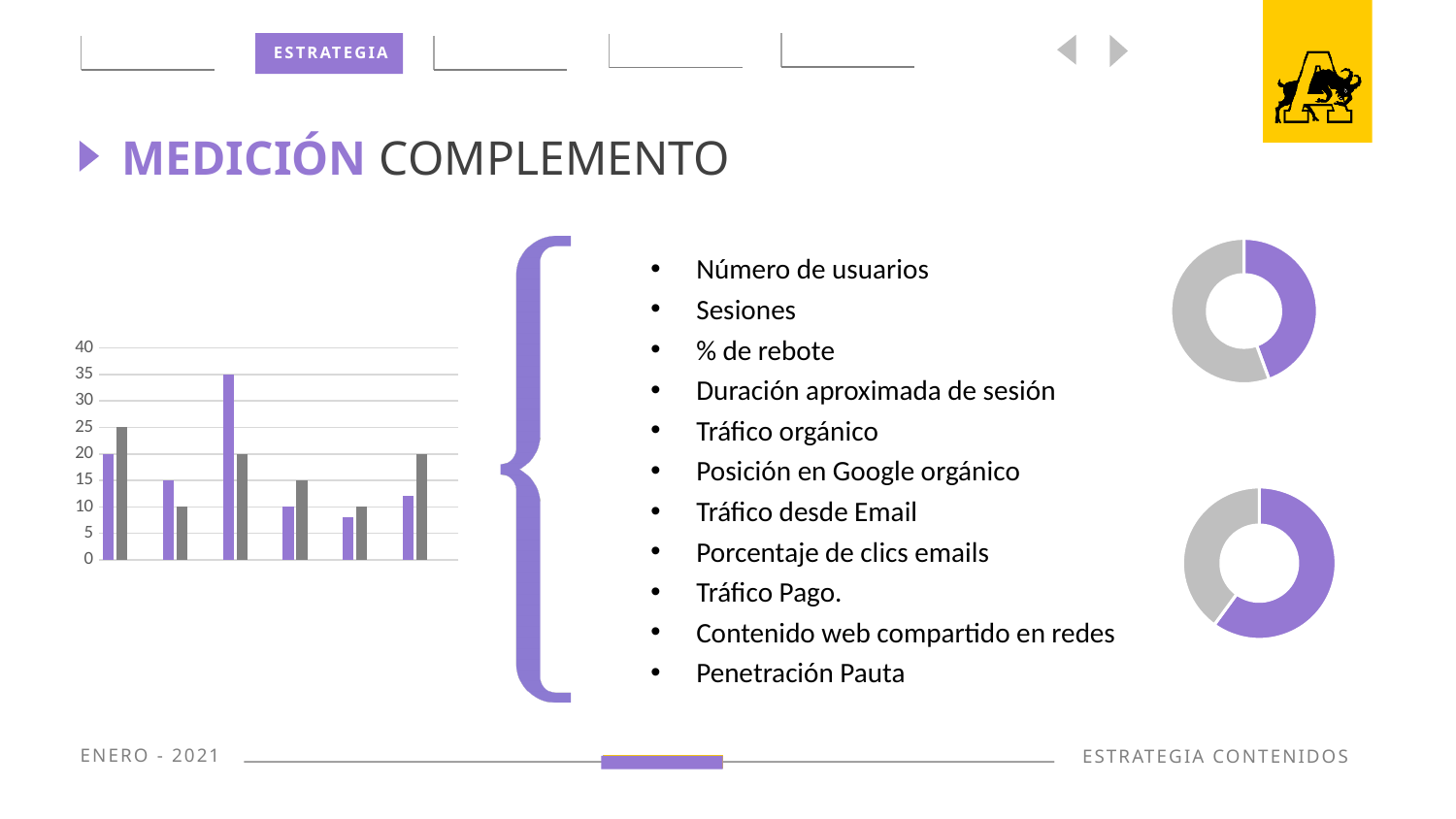
In the bar chart, what colour is the tallest bar? purple In the bottom doughnut chart, which colour takes the larger share, purple or gray? purple In the bar chart, what is the value of the tallest bar? 35 What kind of charts are shown on the right side of the slide? doughnut charts In the bar chart, is the shortest bar greater or less than 10? less What kind of chart is shown on the left side of the slide? bar chart In the bar chart, what is the highest value shown on the vertical axis? 40 How many doughnut charts are on the slide? 2 In the bar chart, how many groups of bars are plotted? 6 In the bar chart, is the tallest bar greater or less than 30? greater